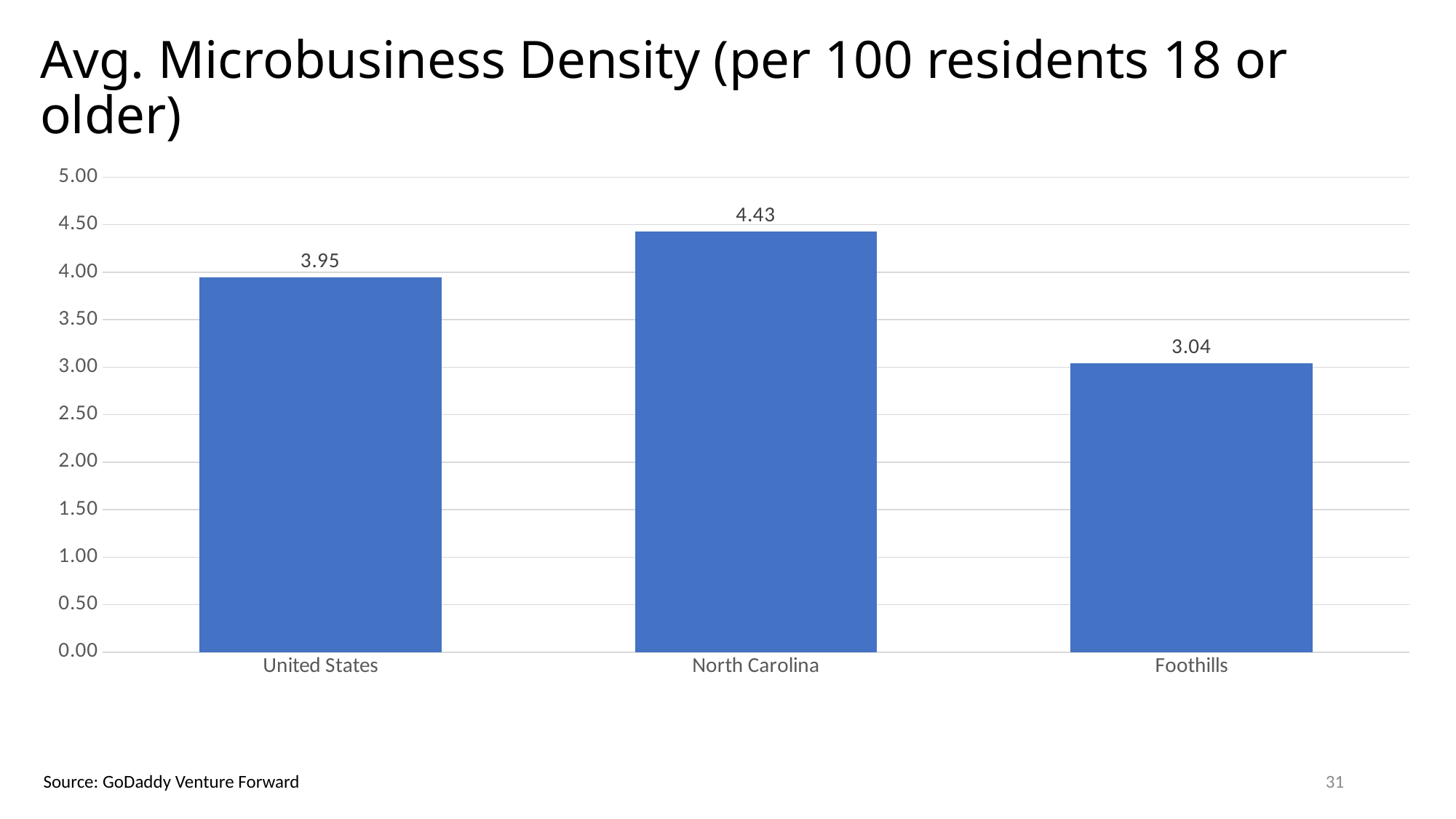
What is the average microbusiness density for North Carolina? 4.43 Which category has the highest average microbusiness density? North Carolina Which is larger, the value for the United States or the value for Foothills? United States What is the difference between the North Carolina and United States values? 0.48 What is the source cited for the chart? GoDaddy Venture Forward Is the value for Foothills greater or less than 3.50? less What kind of chart is shown on the slide? Bar chart What is the average microbusiness density for Foothills? 3.04 What is the average microbusiness density for the United States? 3.95 How many categories are shown on the chart? 3 What is the difference between the North Carolina and Foothills values? 1.39 Which category has the lowest average microbusiness density? Foothills